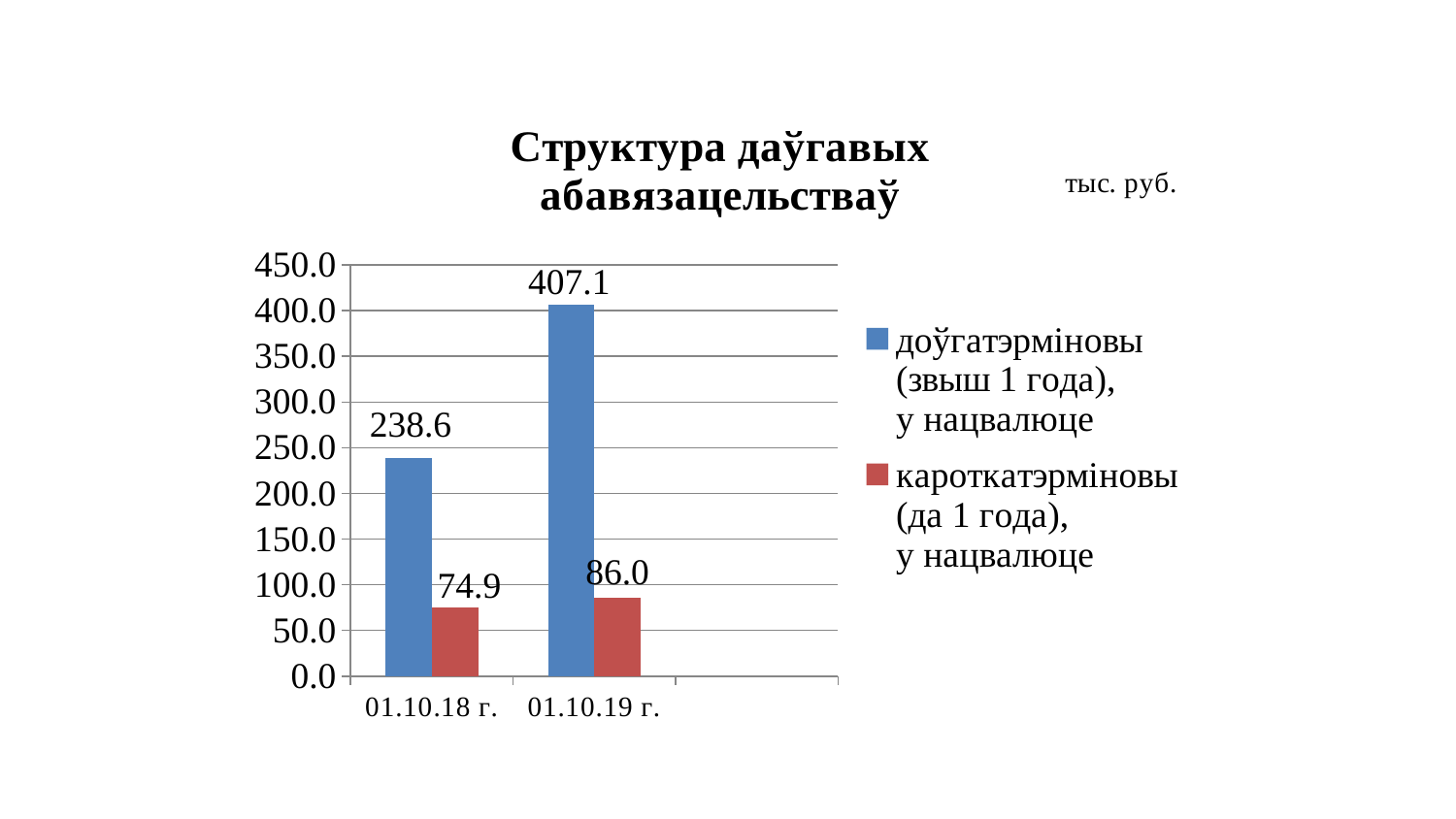
Which bar on the chart has the lowest value? кароткатэрміновы, 01.10.18 г. What is the value of the short-term (кароткатэрміновы) series for 01.10.18 г.? 74.9 How many dates are shown on the x axis? 2 What type of chart is shown on the slide? bar chart What is the difference between the long-term and short-term values for 01.10.19 г.? 321.1 Which is larger for 01.10.18 г.: the long-term or the short-term value? long-term (доўгатэрміновы) Which date has the higher value for the long-term (доўгатэрміновы) series? 01.10.19 г. Is the long-term (доўгатэрміновы) value for 01.10.19 г. greater or less than 400.0? greater What is the value of the short-term (кароткатэрміновы) series for 01.10.19 г.? 86.0 How many series does the legend list? 2 What is the value of the long-term (доўгатэрміновы) series for 01.10.18 г.? 238.6 By how much did the long-term (доўгатэрміновы) value change from 01.10.18 г. to 01.10.19 г.? 168.5